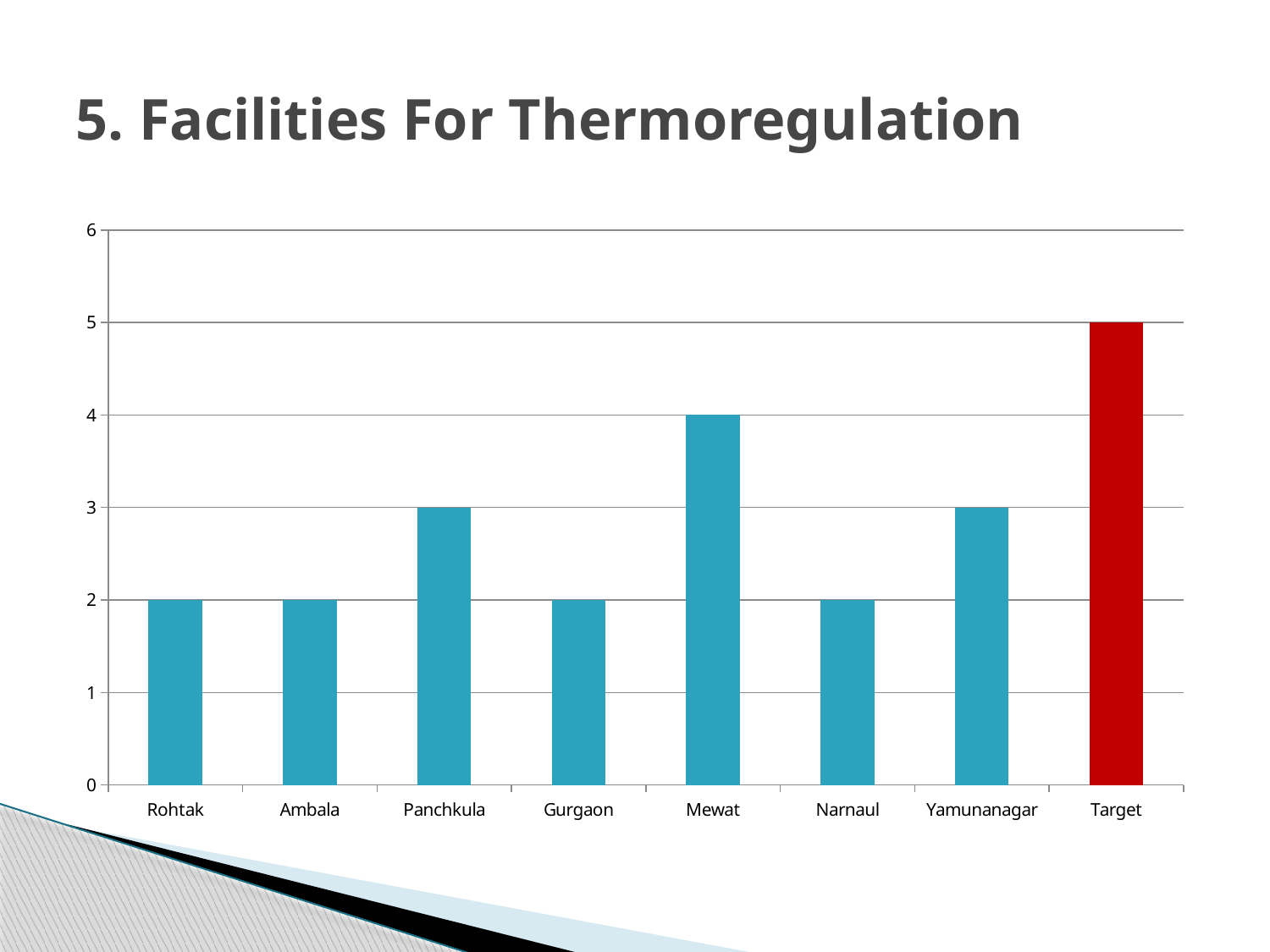
What kind of chart is shown on the slide? Bar chart Which category has the highest value? Target Which bar is coloured red rather than blue? Target What is the difference between the Target value and the Mewat value? 1 Excluding Target, which district has the highest value? Mewat What is the value for Target? 5 How many categories are shown on the x axis? 8 Which is larger, the value for Panchkula or the value for Narnaul? Panchkula What is the value for Panchkula? 3 What is the difference between the Yamunanagar value and the Gurgaon value? 1 What is the value for Mewat? 4 What is the value for Rohtak? 2